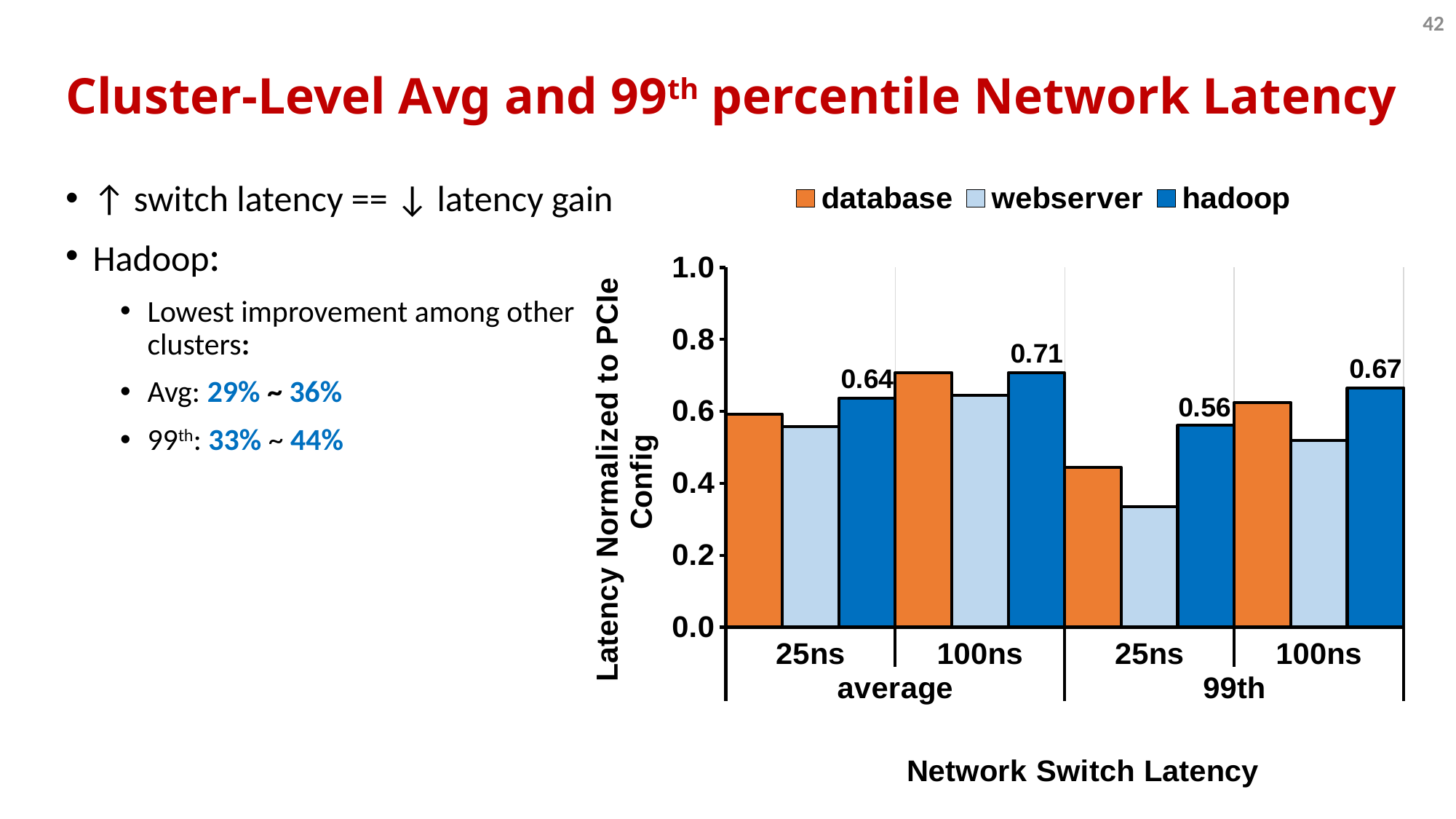
What is the difference between the hadoop values at 100ns and 25ns under 99th? 0.11 What is the value for hadoop at 25ns under 99th? 0.56 In which category does the hadoop series reach its highest value? 100ns (average) What is the difference between the hadoop values at 100ns and 25ns under average? 0.07 Is the value for webserver at 25ns under 99th greater or less than 0.4? less How many series does the legend list? 3 What kind of chart is shown on the slide? Bar chart What is the value for hadoop at 100ns under 99th? 0.67 In which category does the hadoop series have its lowest value? 25ns (99th) Is the value for database at 100ns under average greater or less than 0.6? greater At 25ns under 99th, which is larger: hadoop or webserver? hadoop What is the value for hadoop at 25ns under average? 0.64